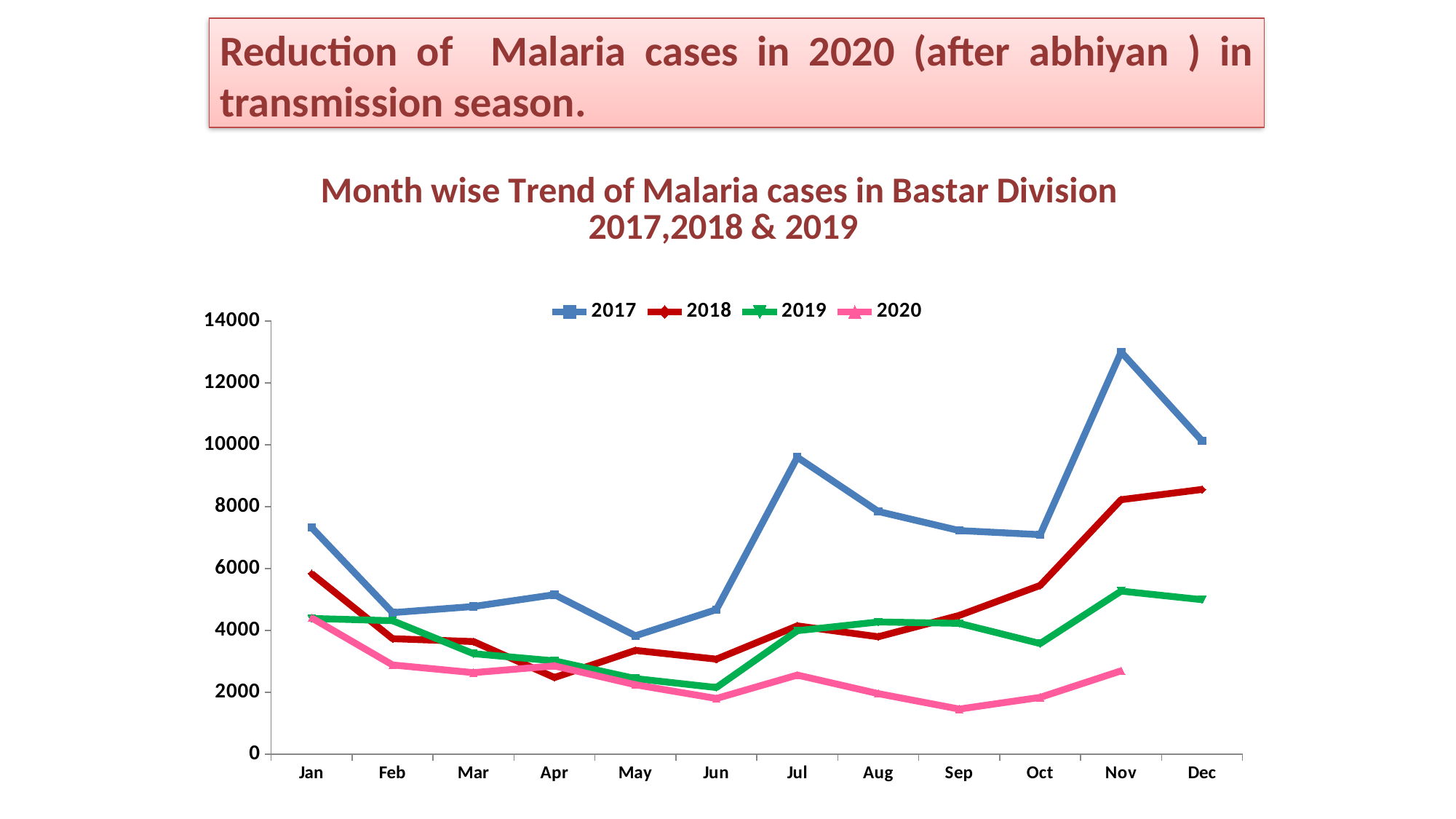
How many series does the legend list? 4 How many months are shown on the x axis? 12 In which month does the 2017 series reach its highest value? Nov Is the value for 2018 in Dec greater or less than 8000? greater Is the value for 2020 in Sep greater or less than 2000? less What kind of chart is shown on the slide? line chart Which series has the lowest value in Nov? 2020 Does the 2020 series rise or fall from Jan to Mar? fall In which month does the 2020 series reach its lowest value? Sep Which series is drawn in pink? 2020 Is the value for 2017 in Nov greater or less than 12000? greater Which is larger in Jul, the value for 2017 or the value for 2018? 2017